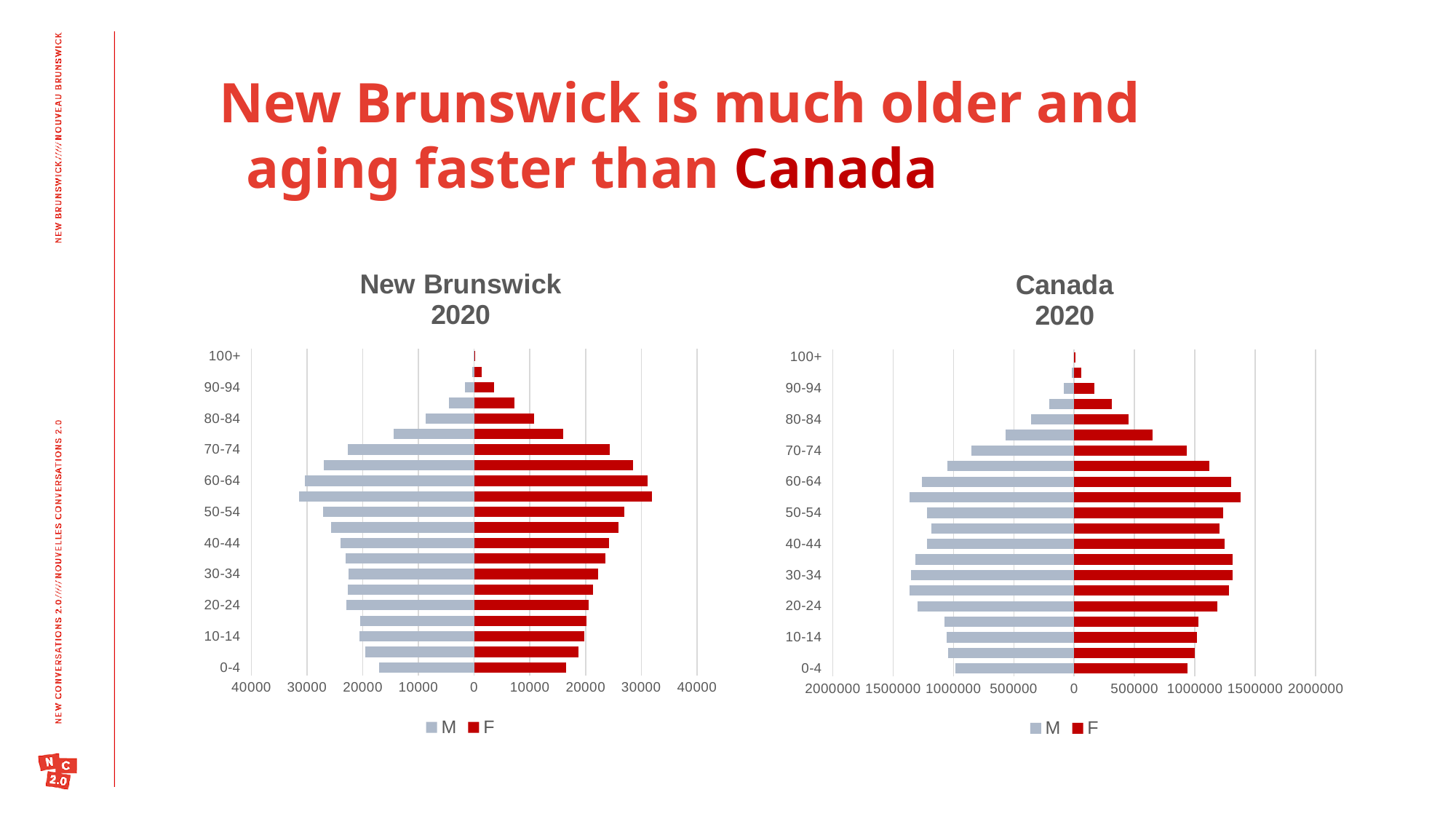
In the New Brunswick 2020 chart, which colour represents the F series? red In the Canada 2020 chart, which is larger for the F series: 30-34 or 80-84? 30-34 In the New Brunswick 2020 chart, is the F value for 70-74 greater or less than 20000? greater In the Canada 2020 chart, is the F value for 60-64 greater or less than 1000000? greater In the Canada 2020 chart, is the M value for 80-84 greater or less than 500000? less What are the two series named in the legend of the New Brunswick 2020 chart? M and F How many series does the legend of the Canada 2020 chart list? 2 In the New Brunswick 2020 chart, which is larger for the F series: 60-64 or 0-4? 60-64 What kind of chart is the New Brunswick 2020 chart? bar chart